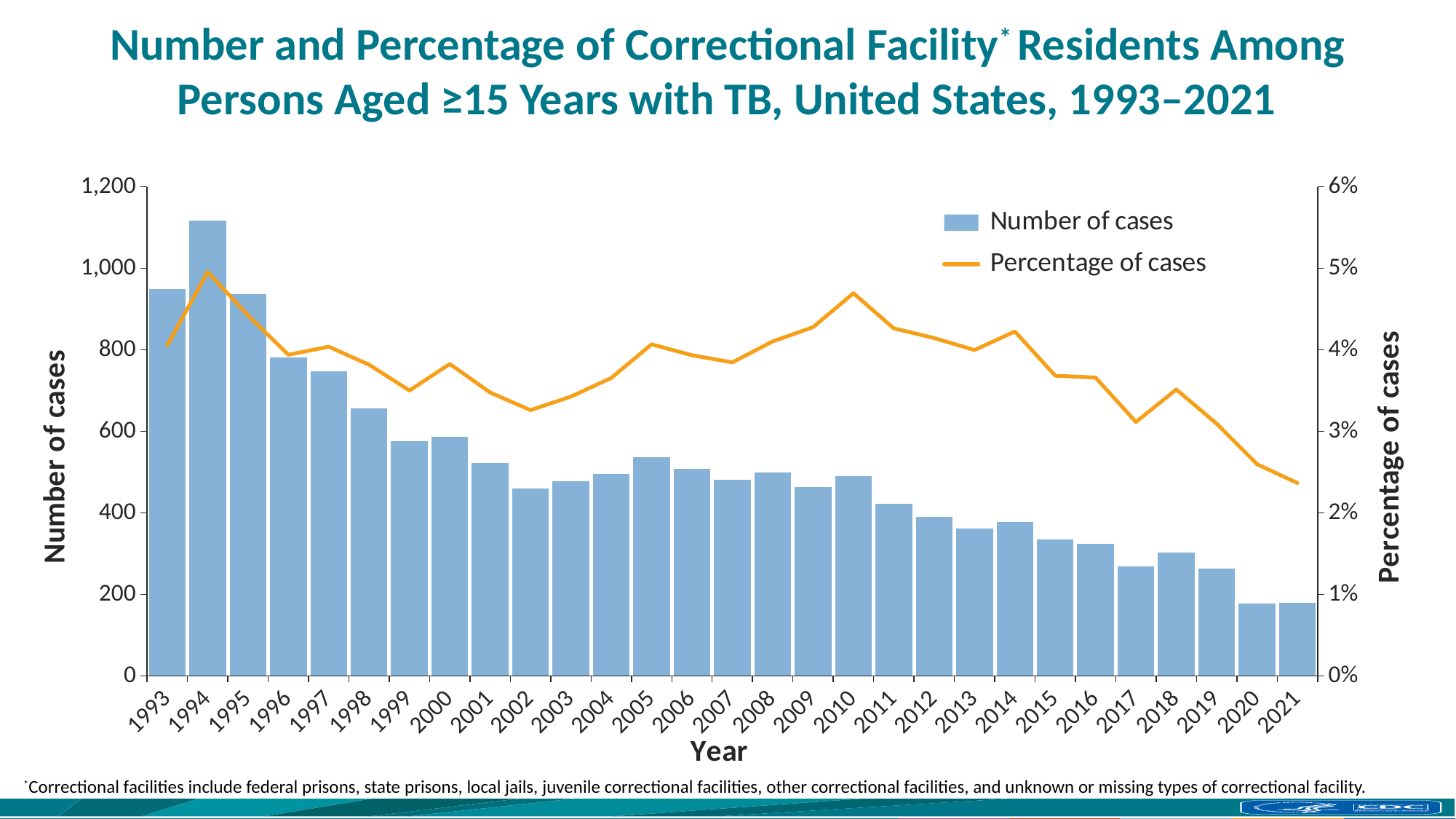
Overall, does the number of cases rise or fall from 1993 to 2021? fall Which year has more cases, 2000 or 2001? 2000 Is the percentage of cases in 2021 greater or less than 3%? less What kind of chart is shown on the slide? A combined bar and line chart Is the percentage of cases in 2010 greater or less than 4%? greater How many years are shown along the x axis? 29 In which year is the percentage of cases lowest? 2021 How many series does the legend list? 2 Is the number of cases in 2002 greater or less than 600? less In which year does the percentage of cases reach its highest point? 1994 Which year has the highest number of cases? 1994